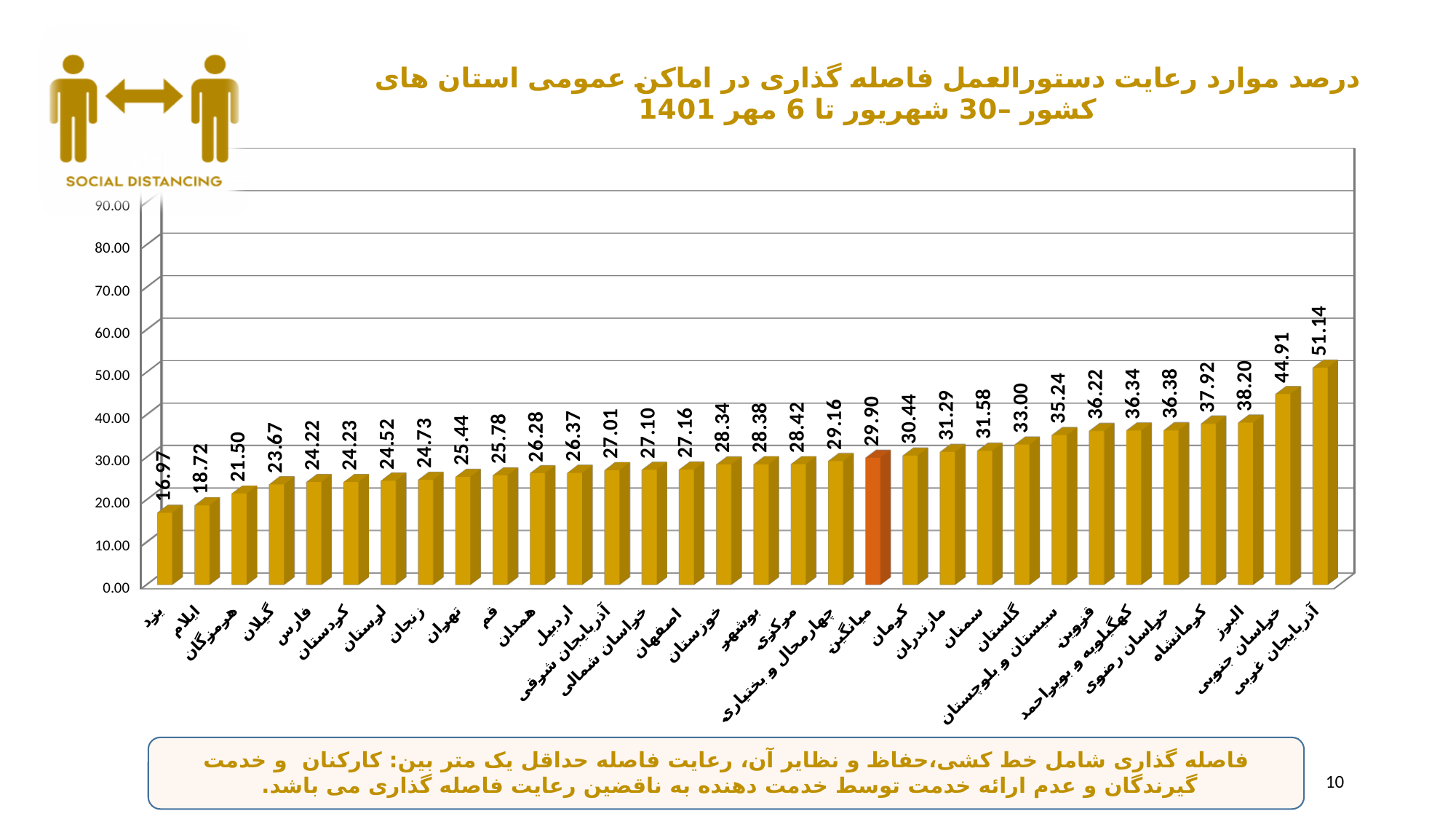
What is the value for تهران (Tehran)? 25.44 Is the value for گلستان greater or less than 30.00? greater Which province has the highest value? آذربایجان غربی What type of chart is shown on the slide? bar chart Which bar is shown in a different colour (orange) from the others? میانگین How many bars are plotted in the chart? 32 Do the values rise or fall moving from left to right along the x axis? rise What is the value for خراسان جنوبی? 44.91 Which is larger, the value for البرز or the value for کرمانشاه? البرز Which province has the lowest value? یزد What is the difference between the values for آذربایجان غربی and یزد? 34.17 What is the value for میانگین (the average bar, highlighted in orange)? 29.90